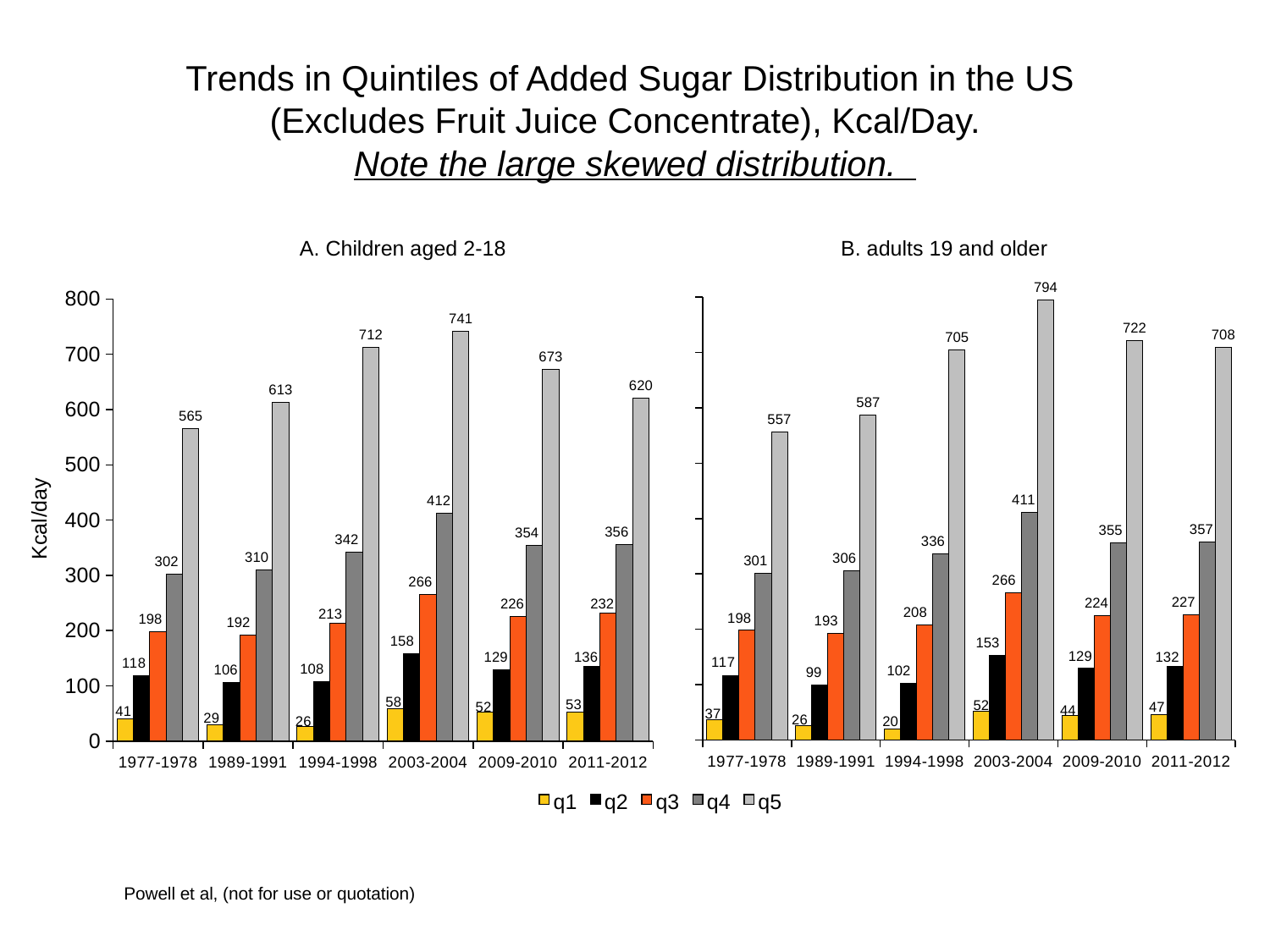
How many time periods are shown on the x axis of chart A (Children aged 2-18)? 6 How many series does the legend list? 5 In chart B (adults 19 and older), what is the q3 value for 1994-1998? 208 What is the label on the y axis of chart A (Children aged 2-18)? Kcal/day In chart B (adults 19 and older), which period has the highest q5 value? 2003-2004 In chart A (Children aged 2-18), is the q4 value for 2003-2004 greater or less than 400? greater In chart A (Children aged 2-18), what is the q5 value for 2003-2004? 741 In chart B (adults 19 and older), which is larger: the q4 value for 2009-2010 or the q4 value for 2011-2012? 2011-2012 In chart B (adults 19 and older), does the q2 value rise or fall from 1994-1998 to 2003-2004? rise In chart A (Children aged 2-18), what is the difference between the q5 values for 2003-2004 and 1977-1978? 176 What kind of chart is chart B (adults 19 and older)? bar chart In chart A (Children aged 2-18), which period has the lowest q1 value? 1994-1998